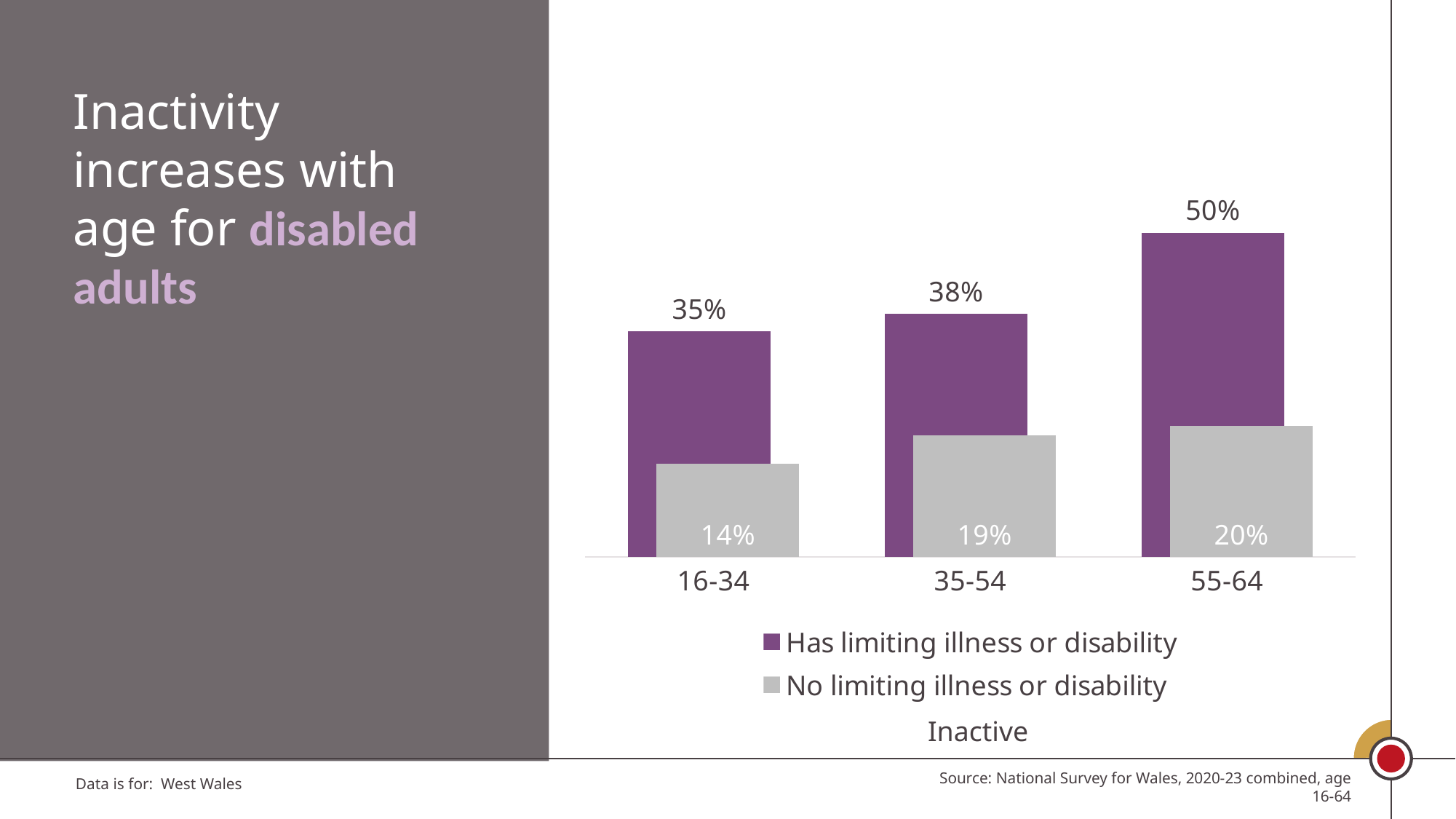
What is the inactivity value for the 35-54 age group among those who have a limiting illness or disability? 38% What is the difference in inactivity between the 55-64 and 16-34 age groups for people with a limiting illness or disability? 15 percentage points What kind of chart is shown on the slide? Bar chart In the 35-54 age group, which is larger: the inactivity value for those with a limiting illness or disability, or those without? Has limiting illness or disability What is the difference between the inactivity values for people with and without a limiting illness or disability in the 55-64 age group? 30 percentage points What is the inactivity value for the 55-64 age group among those with no limiting illness or disability? 20% Do the inactivity values for people with a limiting illness or disability rise or fall as age increases? Rise Which age group has the lowest inactivity value for people with no limiting illness or disability? 16-34 How many age groups are shown on the chart? 3 Which age group has the highest inactivity value for people with a limiting illness or disability? 55-64 What is the inactivity value for the 16-34 age group among those who have a limiting illness or disability? 35% How many series does the legend list? 2